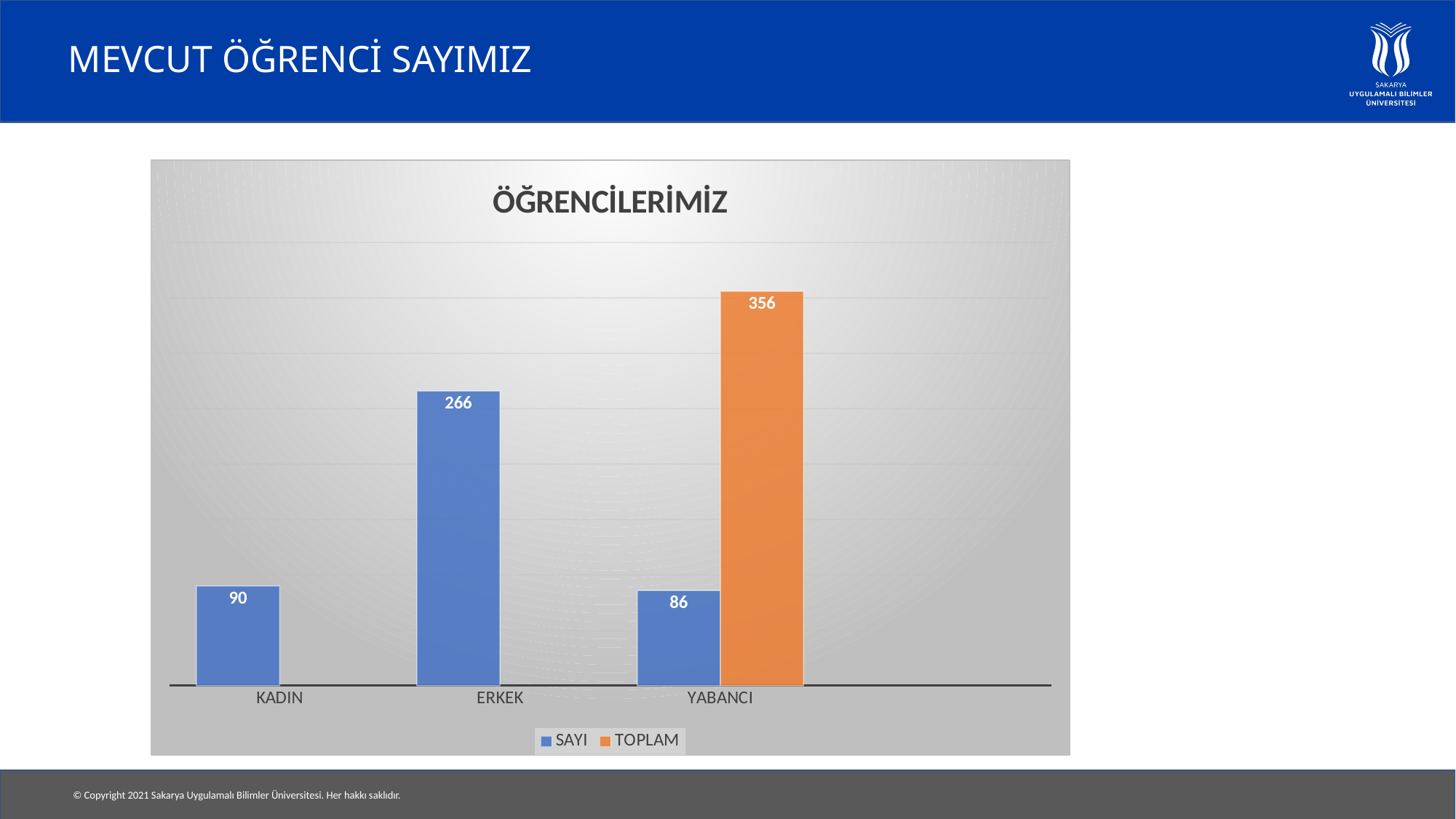
What is the SAYI value for YABANCI? 86 What is the difference between the SAYI values for ERKEK and KADIN? 176 What kind of chart is shown on the slide? Bar chart What is the SAYI value for ERKEK? 266 What is the SAYI value for KADIN? 90 What is the title of the chart? ÖĞRENCİLERİMİZ Which category has the lowest SAYI value? YABANCI What is the TOPLAM value shown for YABANCI? 356 How many categories are shown on the x axis? 3 How many series does the legend list? 2 Which category has the highest SAYI value? ERKEK Which is larger, the SAYI value for KADIN or for YABANCI? KADIN